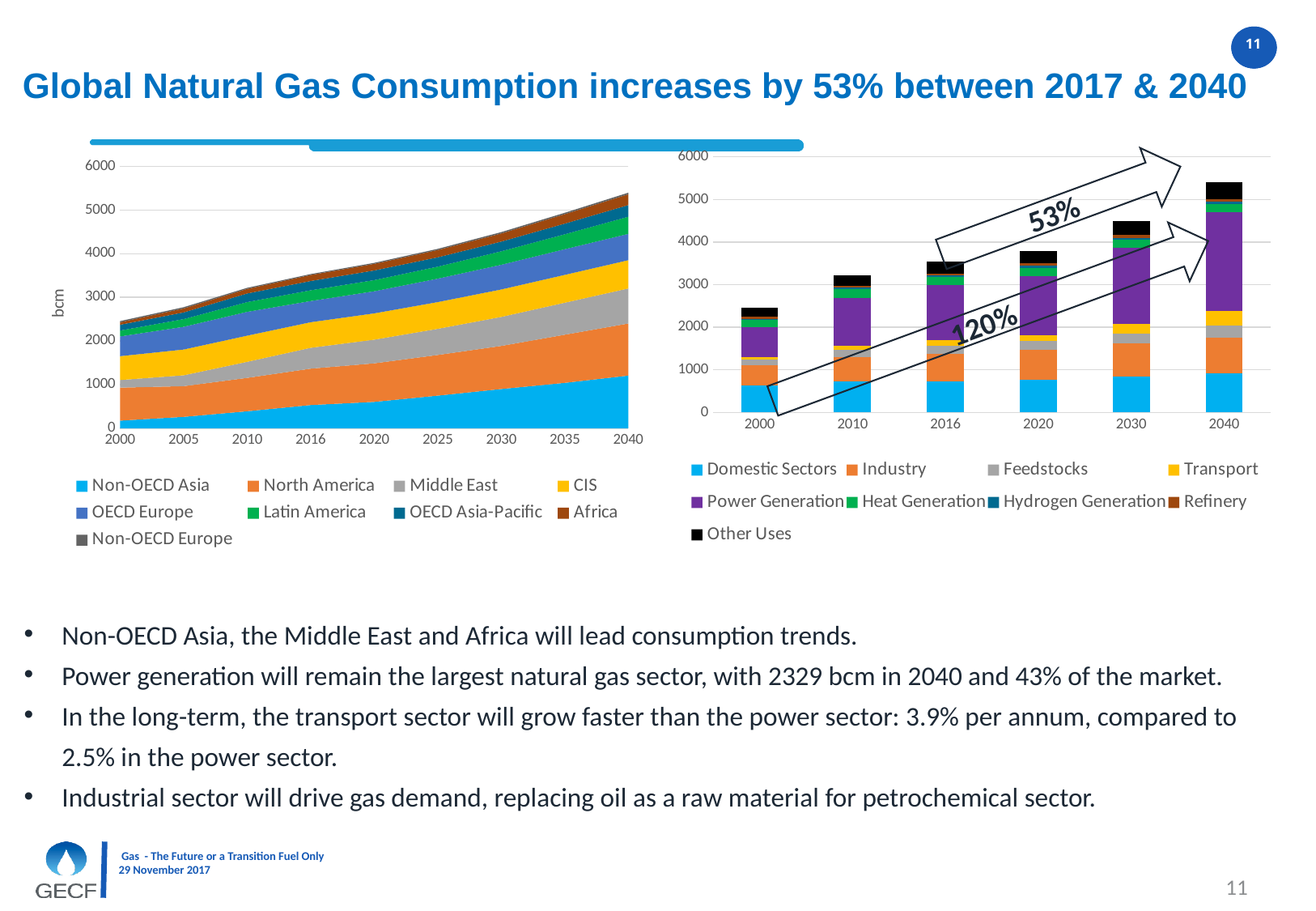
In the right-hand bar chart, is the total for 2000 greater or less than 3000? less What kind of chart is the chart on the left of the slide? stacked area chart In the right-hand bar chart, is the total for 2040 greater or less than 5000? greater How many series does the legend of the left-hand area chart list? 9 What unit is shown on the y axis of the left-hand area chart? bcm How many years are labelled on the x axis of the left-hand area chart? 9 What kind of chart is the chart on the right of the slide? bar chart How many years are shown on the x axis of the right-hand bar chart? 6 In the right-hand bar chart, do the bar totals rise or fall from 2000 to 2040? rise In the right-hand bar chart, which year has the shortest bar? 2000 How many series does the legend of the right-hand bar chart list? 9 In the right-hand bar chart, which year has the tallest bar? 2040